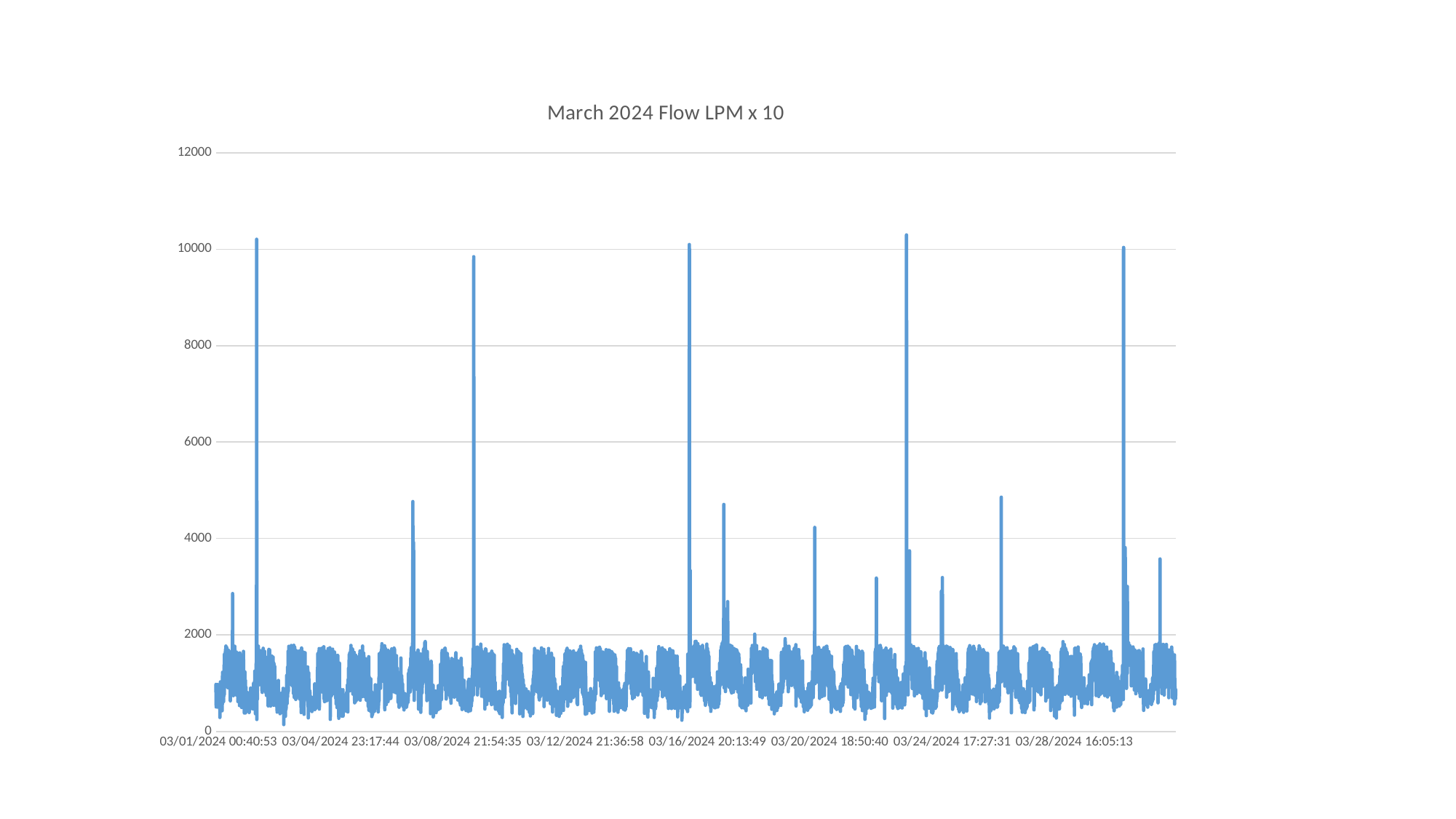
How many spikes in the chart rise above the 8000 gridline? 5 Is the spike just after 03/24/2024 17:27:31 greater or less than 6000? less What is the highest value labelled on the vertical axis? 12000 Is the spike near 03/08/2024 greater or less than 8000? greater Is the spike near 03/01/2024 greater or less than 8000? greater How many spikes in the chart rise above the 6000 gridline? 5 What is the first date label shown on the horizontal axis? 03/01/2024 00:40:53 What kind of chart is shown on the slide? line chart What is the title of the chart? March 2024 Flow LPM x 10